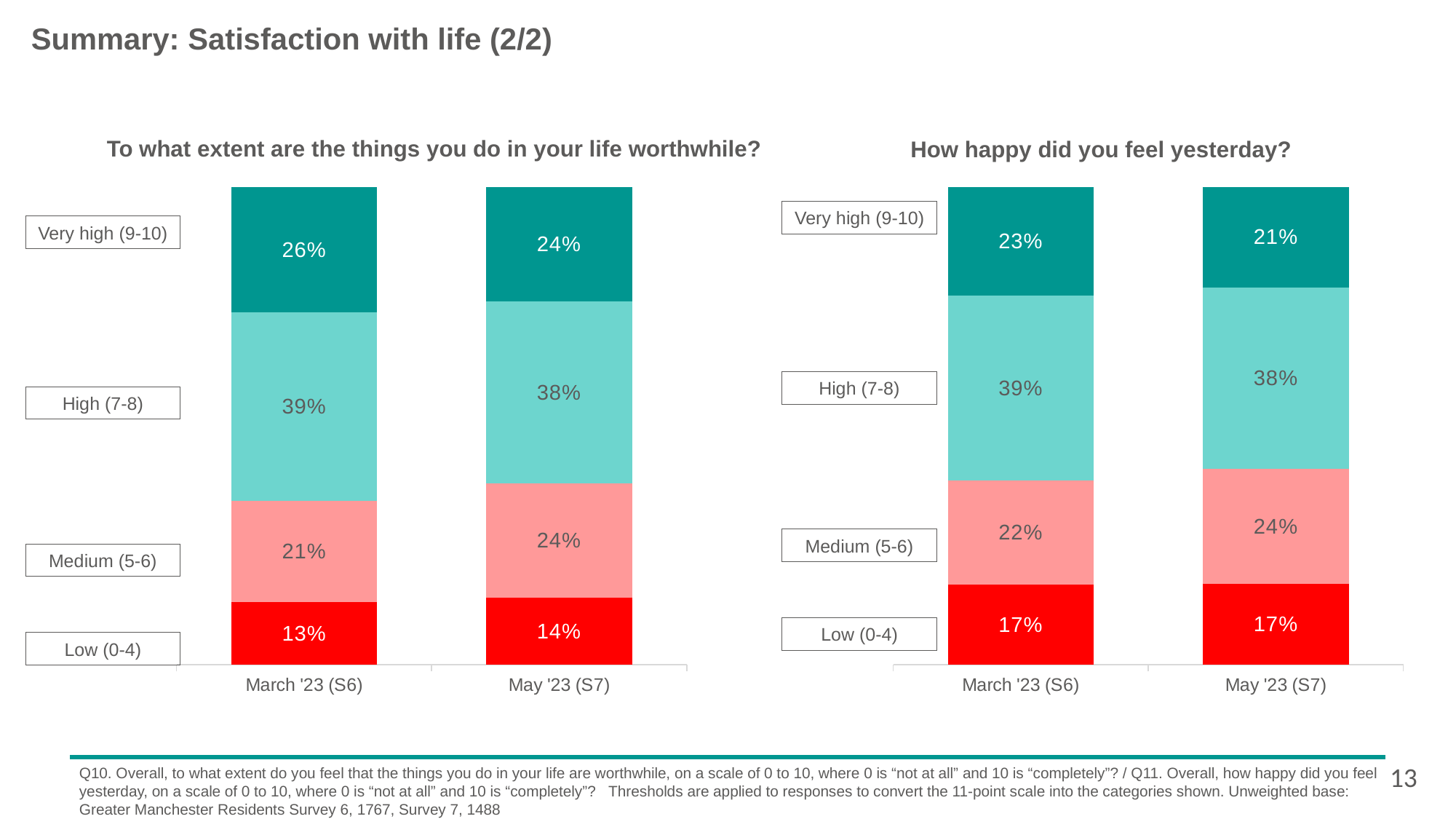
How many rating categories are listed beside the chart 'How happy did you feel yesterday?' 4 What type of chart is used for 'How happy did you feel yesterday?' Stacked bar chart In the chart 'How happy did you feel yesterday?', what is the difference between the High (7-8) and Medium (5-6) shares in March '23 (S6)? 17 percentage points In the chart 'To what extent are the things you do in your life worthwhile?', what is the Medium (5-6) value for May '23 (S7)? 24% In the chart 'How happy did you feel yesterday?', what is the Low (0-4) value for March '23 (S6)? 17% In the chart 'How happy did you feel yesterday?', which category has the smallest share in May '23 (S7)? Low (0-4) In the chart 'To what extent are the things you do in your life worthwhile?', which category has the largest share in March '23 (S6)? High (7-8) How many time periods are shown on the x axis of the chart 'To what extent are the things you do in your life worthwhile?' 2 In the chart 'To what extent are the things you do in your life worthwhile?', by how many percentage points did the Very high (9-10) share change from March '23 (S6) to May '23 (S7)? 2 percentage points lower In the chart 'How happy did you feel yesterday?', is the Medium (5-6) share larger in March '23 (S6) or May '23 (S7)? May '23 (S7) In the chart 'How happy did you feel yesterday?', what is the Very high (9-10) value for May '23 (S7)? 21% In the chart 'To what extent are the things you do in your life worthwhile?', what percentage of respondents gave a Very high (9-10) rating in March '23 (S6)? 26%